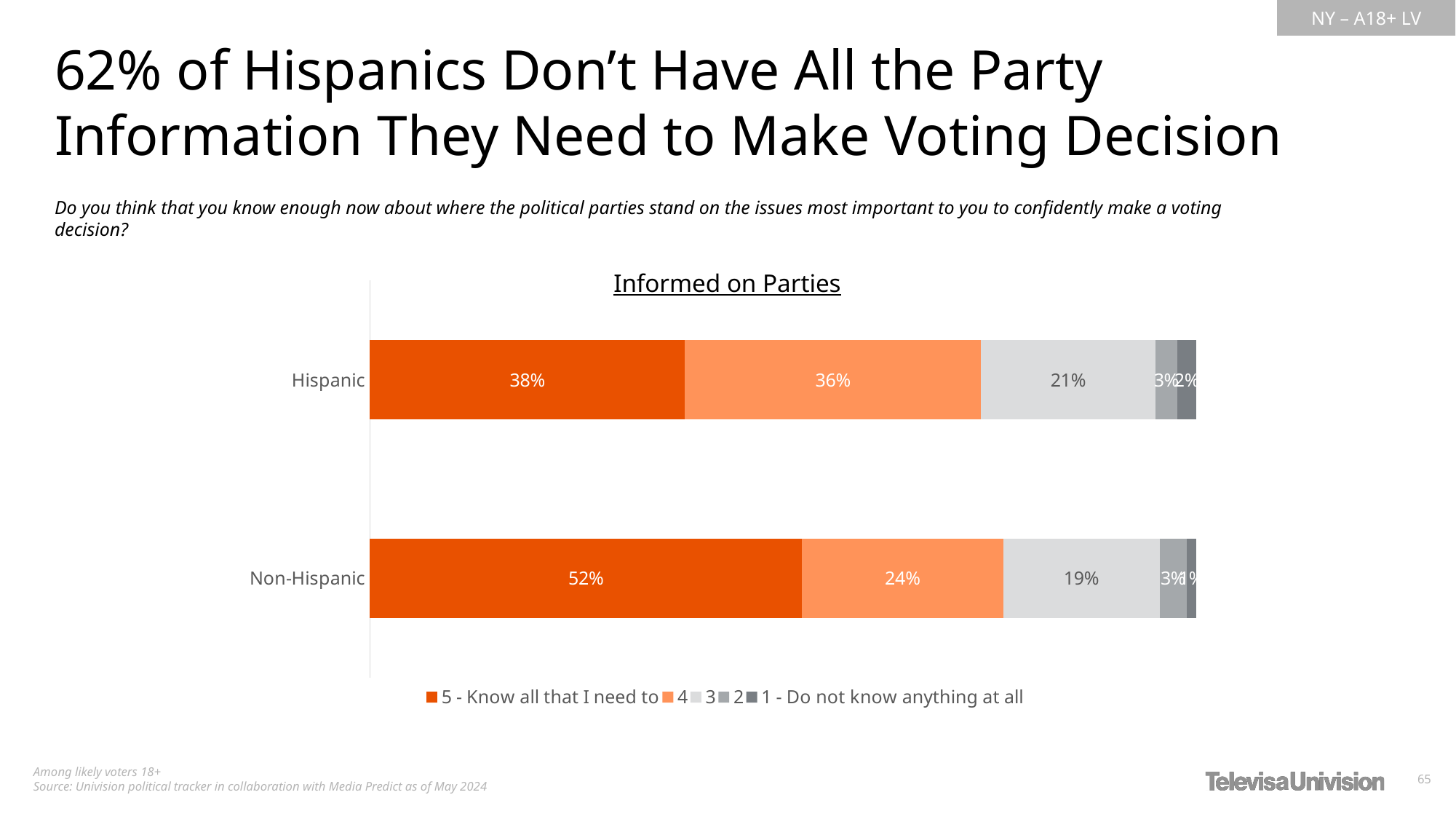
Which group has the higher share for "5 - Know all that I need to"? Non-Hispanic What is the value for the "3" segment in the Hispanic bar? 21% What type of chart is shown on the slide? Stacked bar chart How many groups (categories) are shown in the chart? 2 Which group has the larger "4" segment, Hispanic or Non-Hispanic? Hispanic What percentage of Hispanic respondents chose "5 - Know all that I need to"? 38% How many percentage points higher is the "5 - Know all that I need to" share for Non-Hispanic than for Hispanic? 14 percentage points What percentage of Non-Hispanic respondents chose "5 - Know all that I need to"? 52% How many series does the legend list? 5 What is the value for the "3" segment in the Non-Hispanic bar? 19% What is the title of the chart? Informed on Parties What is the value for the "4" segment in the Hispanic bar? 36%